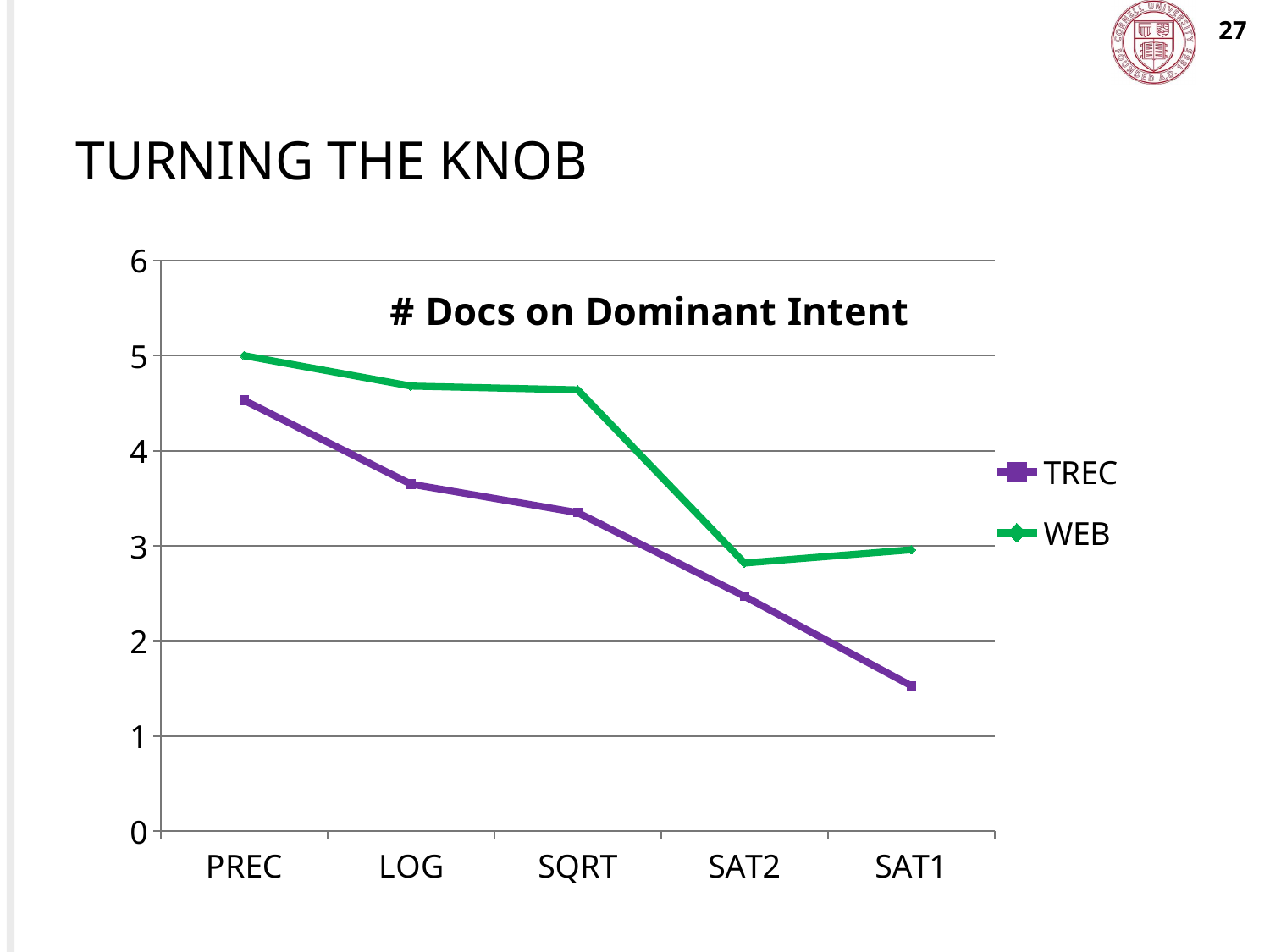
What is the value of the WEB series at PREC? 5 How many categories are shown on the x axis? 5 At which category does the TREC series reach its lowest value? SAT1 Is the value of the WEB series at LOG greater or less than 4? greater At SAT1, which series has the larger value, TREC or WEB? WEB Is the value of the TREC series at PREC greater or less than 4? greater What type of chart is shown on the slide? line chart Is the value of the WEB series at SAT2 greater or less than 3? less What is the title of the chart? # Docs on Dominant Intent How many series does the legend list? 2 At which category does the WEB series reach its highest value? PREC